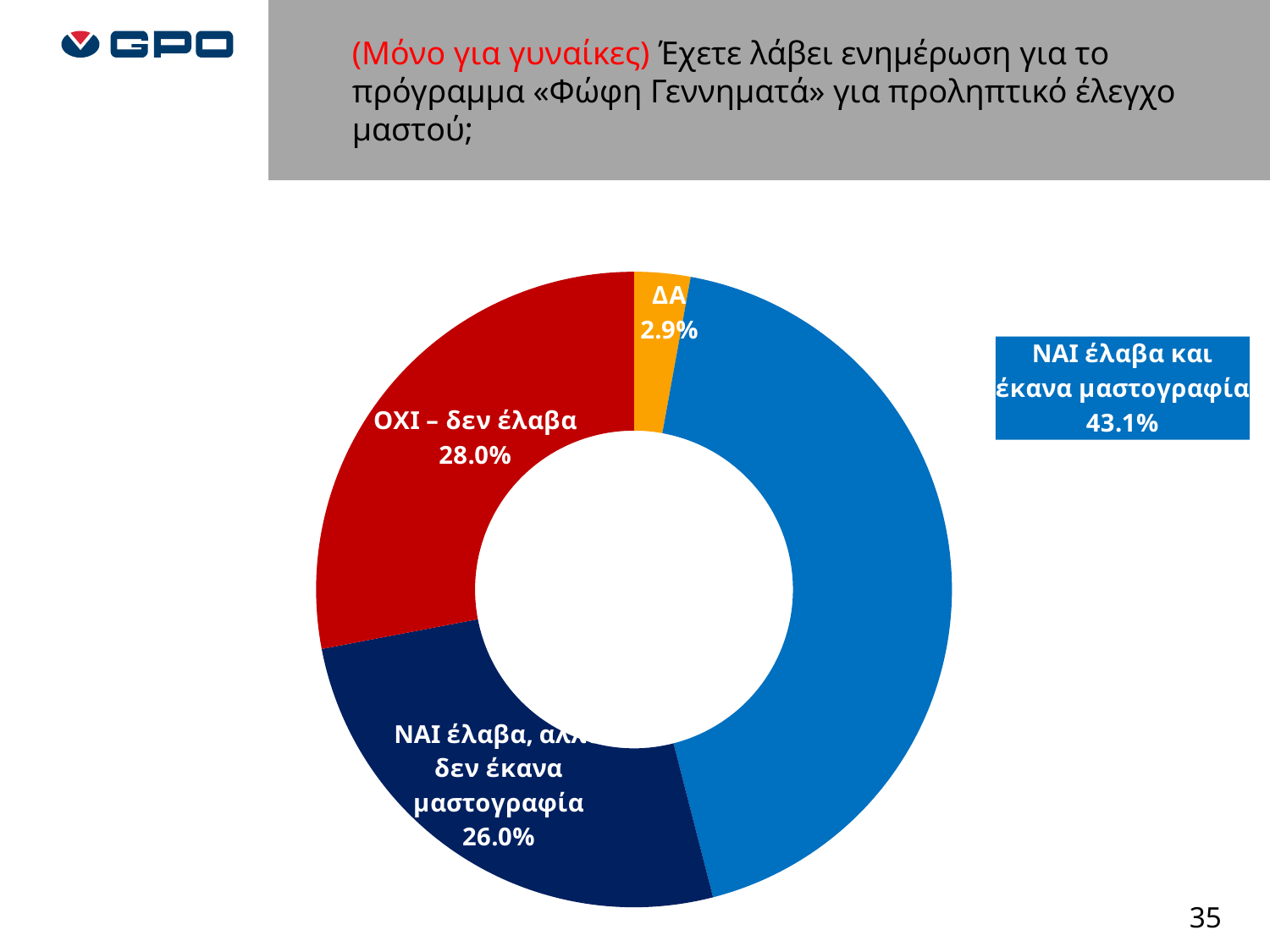
What percentage of respondents answered "ΟΧΙ – δεν έλαβα"? 28.0% Which response has the largest share of the pie? ΝΑΙ έλαβα και έκανα μαστογραφία What colour is the slice for "ΟΧΙ – δεν έλαβα"? Red Which response has the smallest share of the pie? ΔΑ What kind of chart is shown on the slide? Pie chart (donut) Which is larger: the share for "ΟΧΙ – δεν έλαβα" or the share for "ΝΑΙ έλαβα, αλλά δεν έκανα μαστογραφία"? ΟΧΙ – δεν έλαβα What percentage of respondents answered "ΔΑ"? 2.9% What percentage of respondents answered "ΝΑΙ έλαβα, αλλά δεν έκανα μαστογραφία"? 26.0% How many response categories are shown in the chart? 4 What is the difference in percentage points between "ΝΑΙ έλαβα και έκανα μαστογραφία" and "ΟΧΙ – δεν έλαβα"? 15.1 percentage points What is the combined share of the two "ΝΑΙ έλαβα" responses? 69.1% What percentage of respondents answered "ΝΑΙ έλαβα και έκανα μαστογραφία"? 43.1%